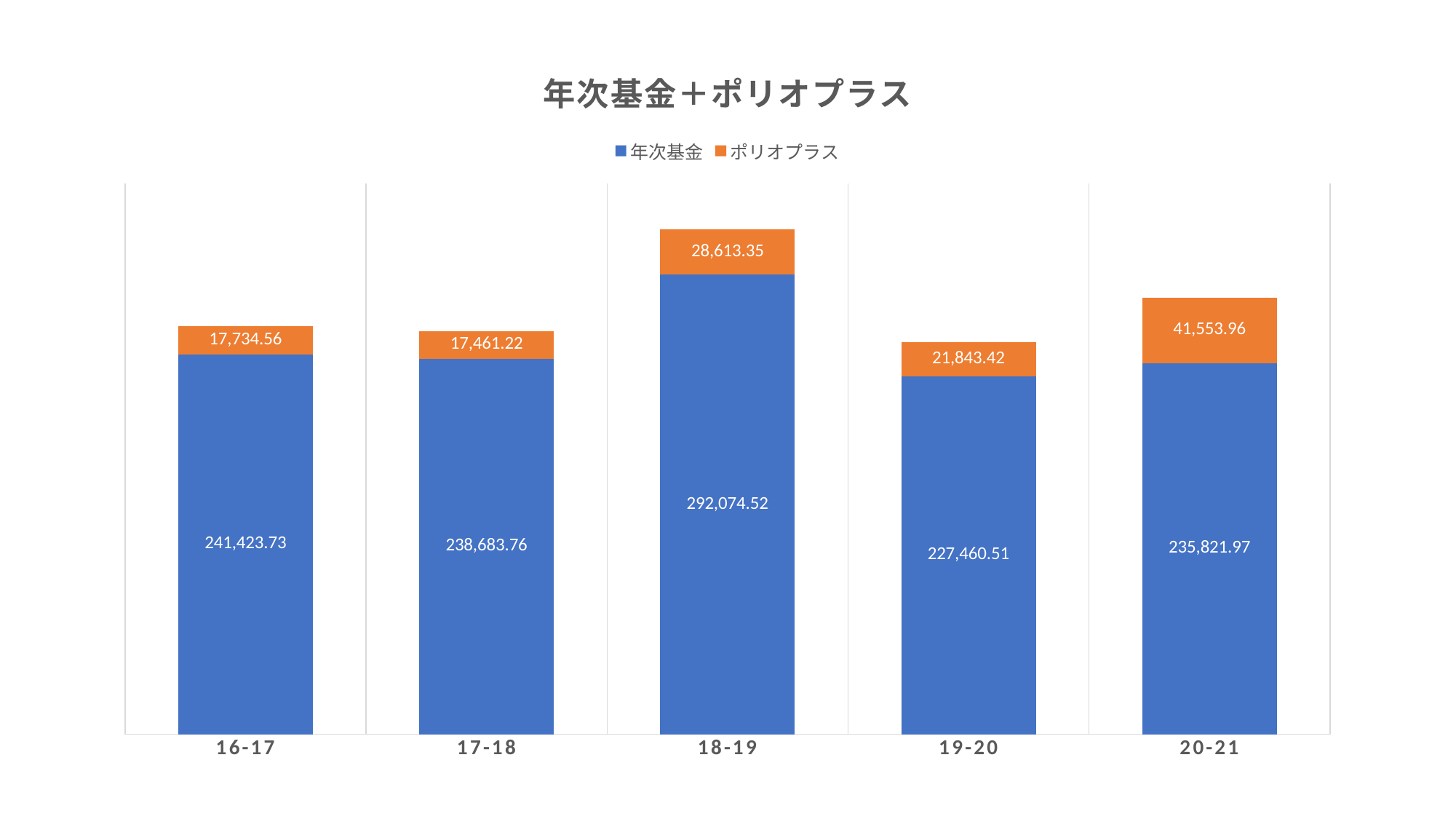
How many series does the legend list? 2 Which year has the lowest ポリオプラス value? 17-18 What is the total of the stacked bar for 16-17? 259,158.29 What is the 年次基金 value for 19-20? 227,460.51 What is the ポリオプラス value for 20-21? 41,553.96 What is the difference between the 年次基金 values for 18-19 and 19-20? 64,614.01 What is the 年次基金 value for 18-19? 292,074.52 How many categories are shown on the x axis? 5 What type of chart is shown on the slide? Stacked bar chart What is the title of the chart? 年次基金＋ポリオプラス Which is larger, the ポリオプラス value for 20-21 or for 18-19? 20-21 Which year has the highest 年次基金 value? 18-19